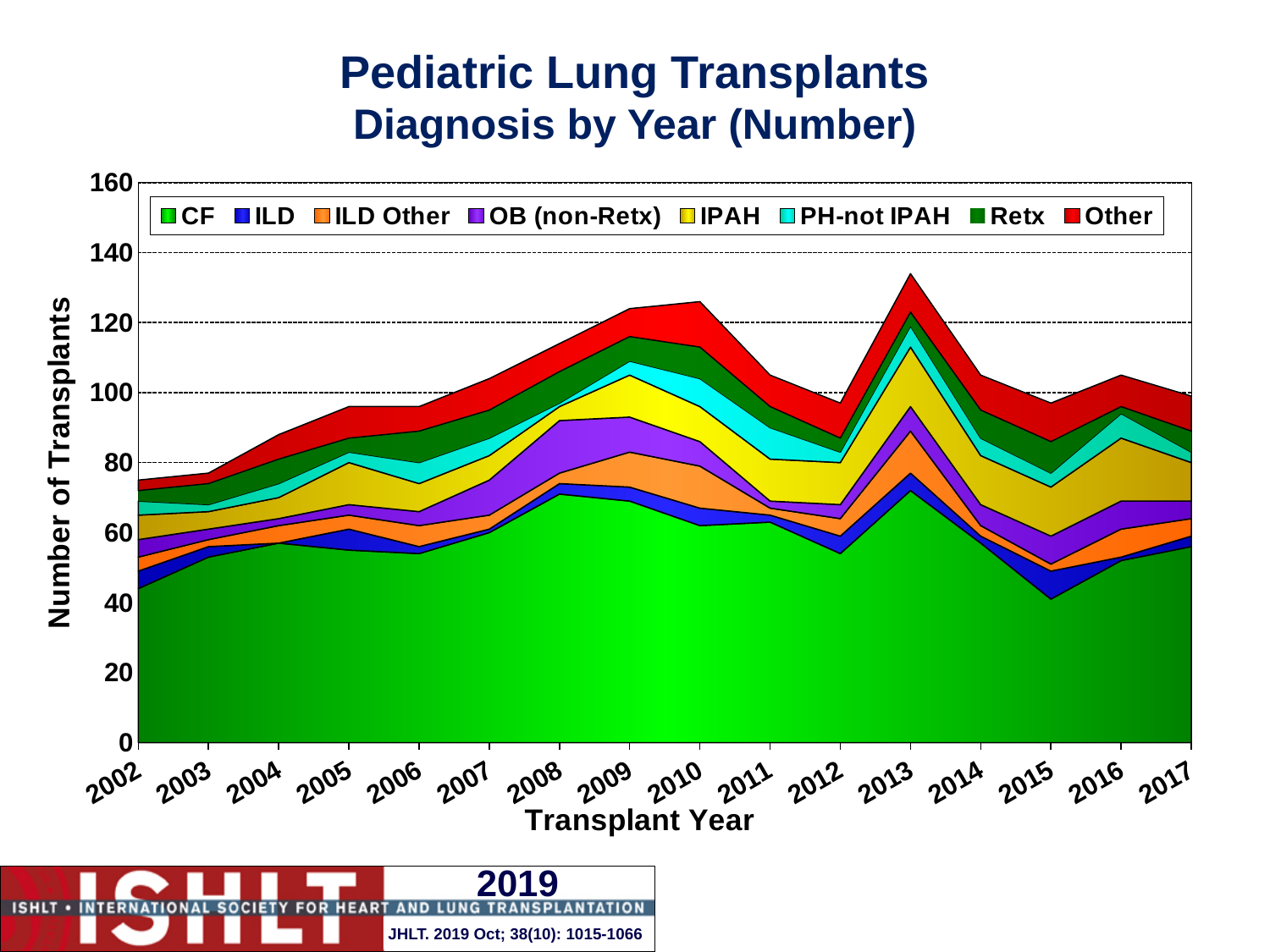
What is the label of the y axis? Number of Transplants Does the total number of transplants rise or fall from 2013 to 2015? fall Is the total number of transplants in 2013 greater or less than 120? greater What kind of chart is shown on the slide? Stacked area chart Is the number of CF transplants in 2015 greater or less than 60? less Is the total number of transplants in 2002 greater or less than 80? less How many series does the legend list? 8 Which year has a larger total number of transplants, 2002 or 2010? 2010 How many transplant years are shown on the x axis? 16 In which transplant year is the total number of pediatric lung transplants highest? 2013